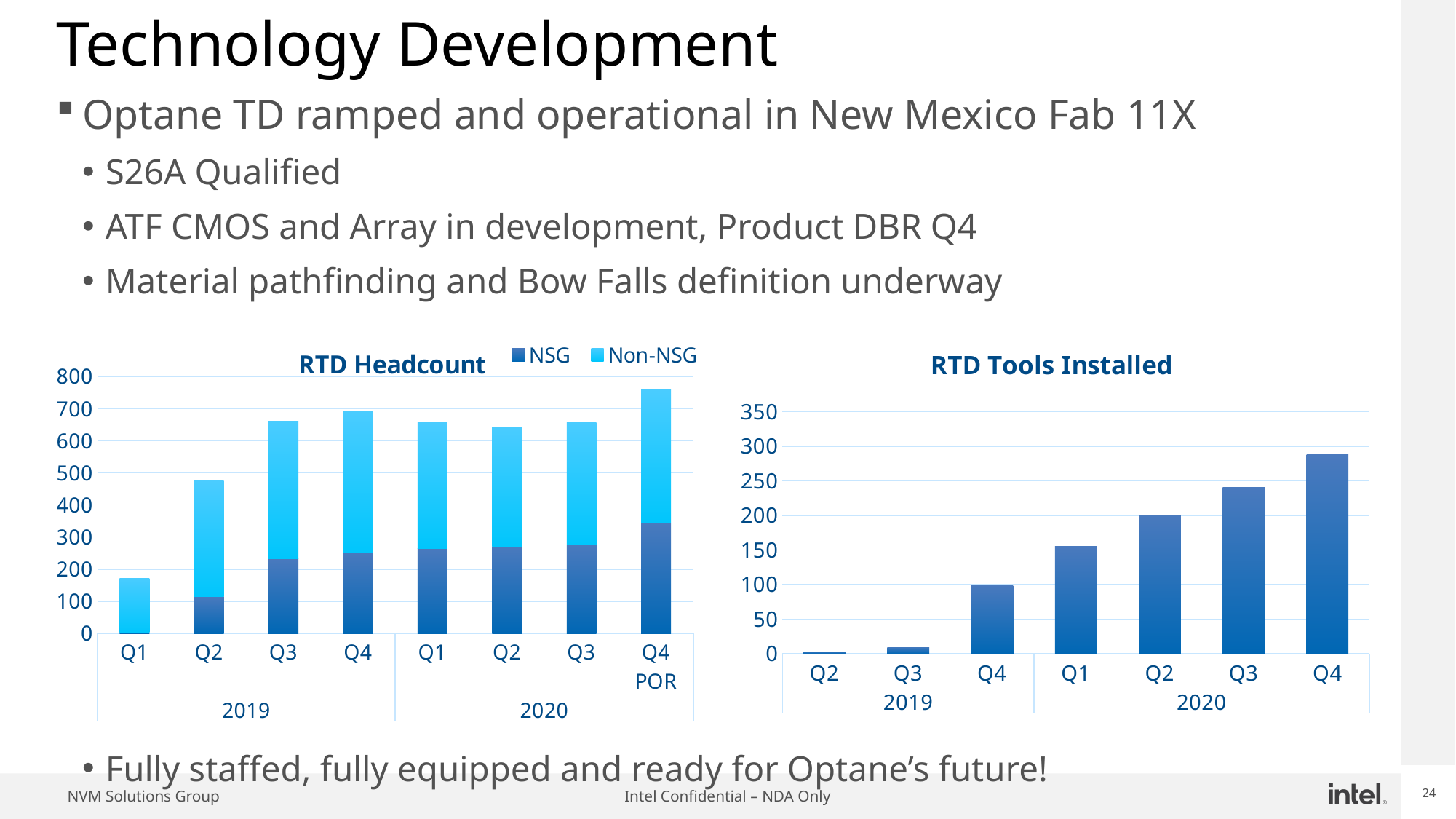
How many quarters are plotted in the RTD Headcount chart? 8 How many series does the legend of the RTD Headcount chart list? 2 What type of chart is the RTD Tools Installed chart? bar chart What are the two series named in the legend of the RTD Headcount chart? NSG and Non-NSG In the RTD Headcount chart, is the total headcount for Q1 2019 greater or less than 200? less In the RTD Tools Installed chart, is the value for Q4 2020 greater or less than 250? greater In the RTD Headcount chart, which quarter has the highest total headcount? Q4 2020 POR In the RTD Tools Installed chart, which quarter has the highest value? Q4 2020 In the RTD Tools Installed chart, is the value for Q3 2020 greater or less than 200? greater In the RTD Tools Installed chart, do the values rise or fall from Q2 2019 to Q4 2020? rise In the RTD Tools Installed chart, which quarter has the lowest value? Q2 2019 How many quarters are plotted in the RTD Tools Installed chart? 7